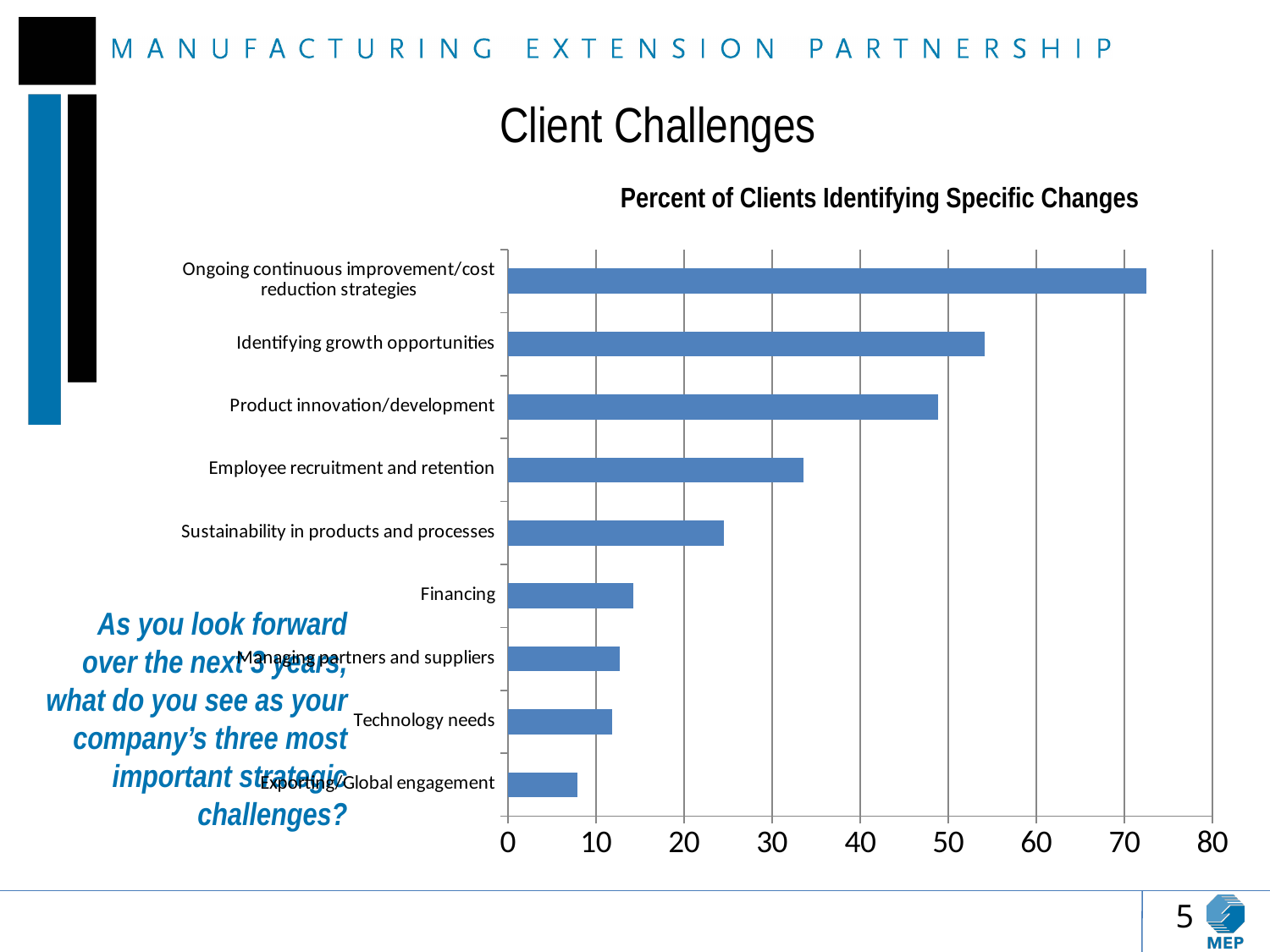
What kind of chart is shown on the slide? bar chart Which category has the highest value? Ongoing continuous improvement/cost reduction strategies Is the value for Product innovation/development greater or less than 50? less Is the value for Identifying growth opportunities greater or less than 50? greater How many categories are plotted in the chart? 9 Is the value for Employee recruitment and retention greater or less than 30? greater Which is larger, the value for Financing or the value for Exporting/Global engagement? Financing What is the title of the chart? Percent of Clients Identifying Specific Changes Which category has the lowest value? Exporting/Global engagement Which is larger, the value for Product innovation/development or the value for Employee recruitment and retention? Product innovation/development